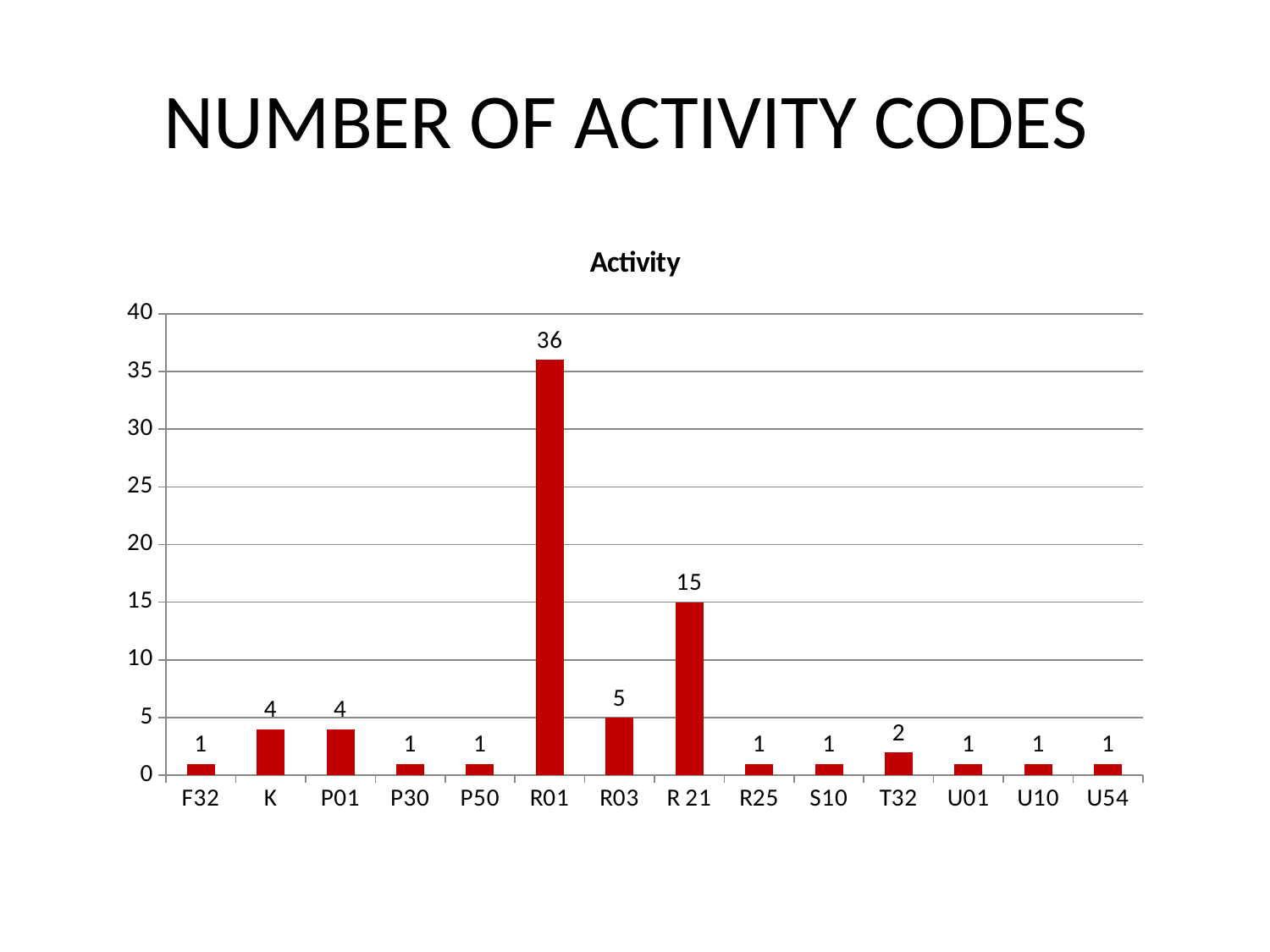
What is the difference between the values for R01 and R 21? 21 Which activity code has the highest value? R01 What is the value for R 21? 15 What is the title of the chart? Activity What colour are the bars in the chart? red Which is larger, the value for K or the value for R03? R03 What is the value for R03? 5 Is the value for R01 greater or less than 30? greater How many activity codes are shown on the x axis? 14 What is the value for R01? 36 What is the value for T32? 2 What kind of chart is shown on the slide? bar chart